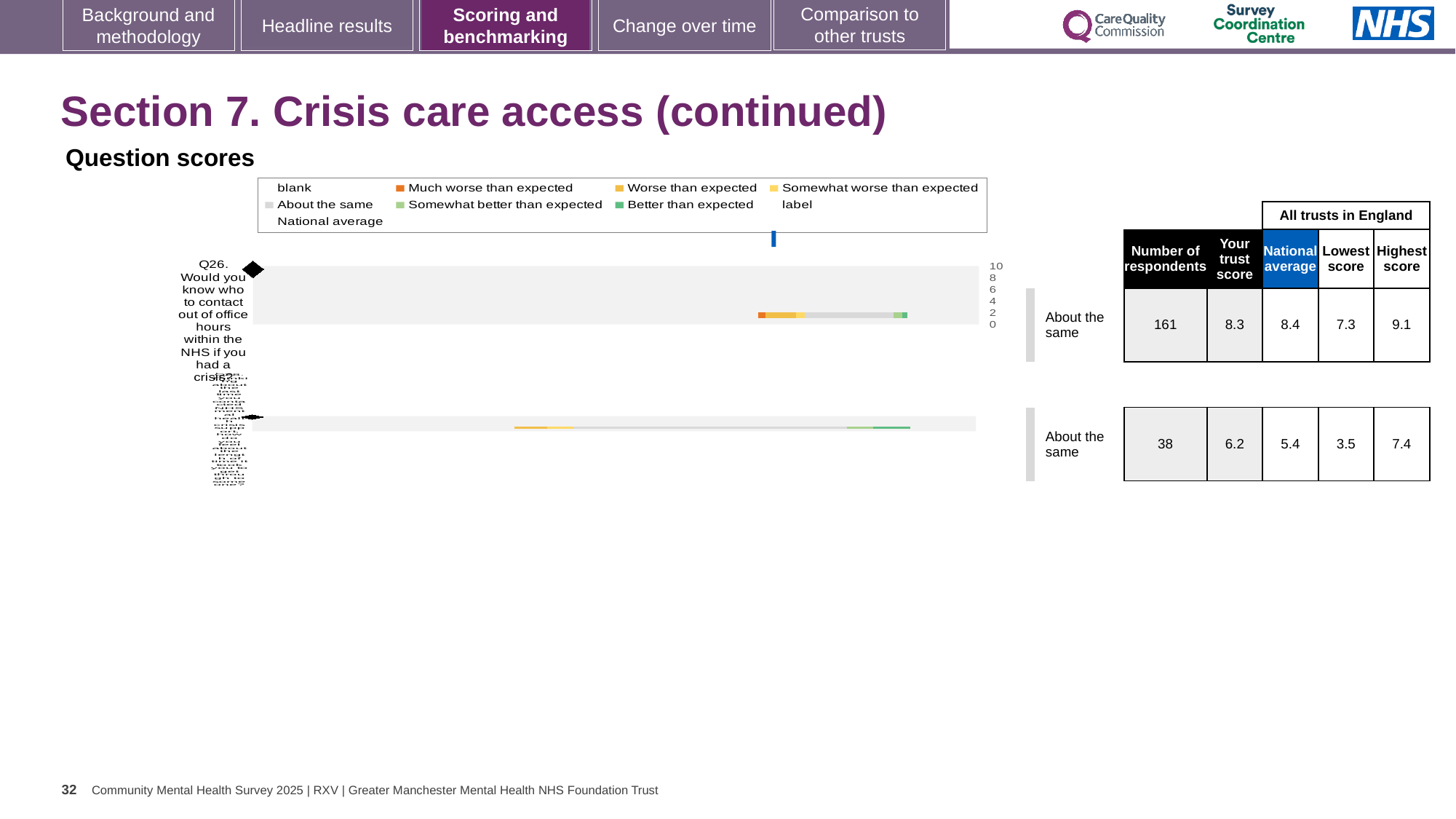
What is the lowest score among all trusts in England for Q26? 7.3 For Q26, which is larger: your trust score or the national average? National average How many questions (rows) are plotted in the Question scores chart? 2 What kind of chart is shown under 'Question scores'? bar chart What benchmark category is shown for Q26 next to the chart? About the same For Q26, what is the difference between the highest score and the lowest score across all trusts in England? 1.8 In the second (lower) row of the table, what is the number of respondents? 38 What is the national average score for Q26? 8.4 What is 'Your trust score' for Q26? 8.3 What is the highest score among all trusts in England for Q26? 9.1 In the table beside the chart, what is the number of respondents for Q26? 161 In the second (lower) row of the table, what is the difference between your trust score and the national average? 0.8